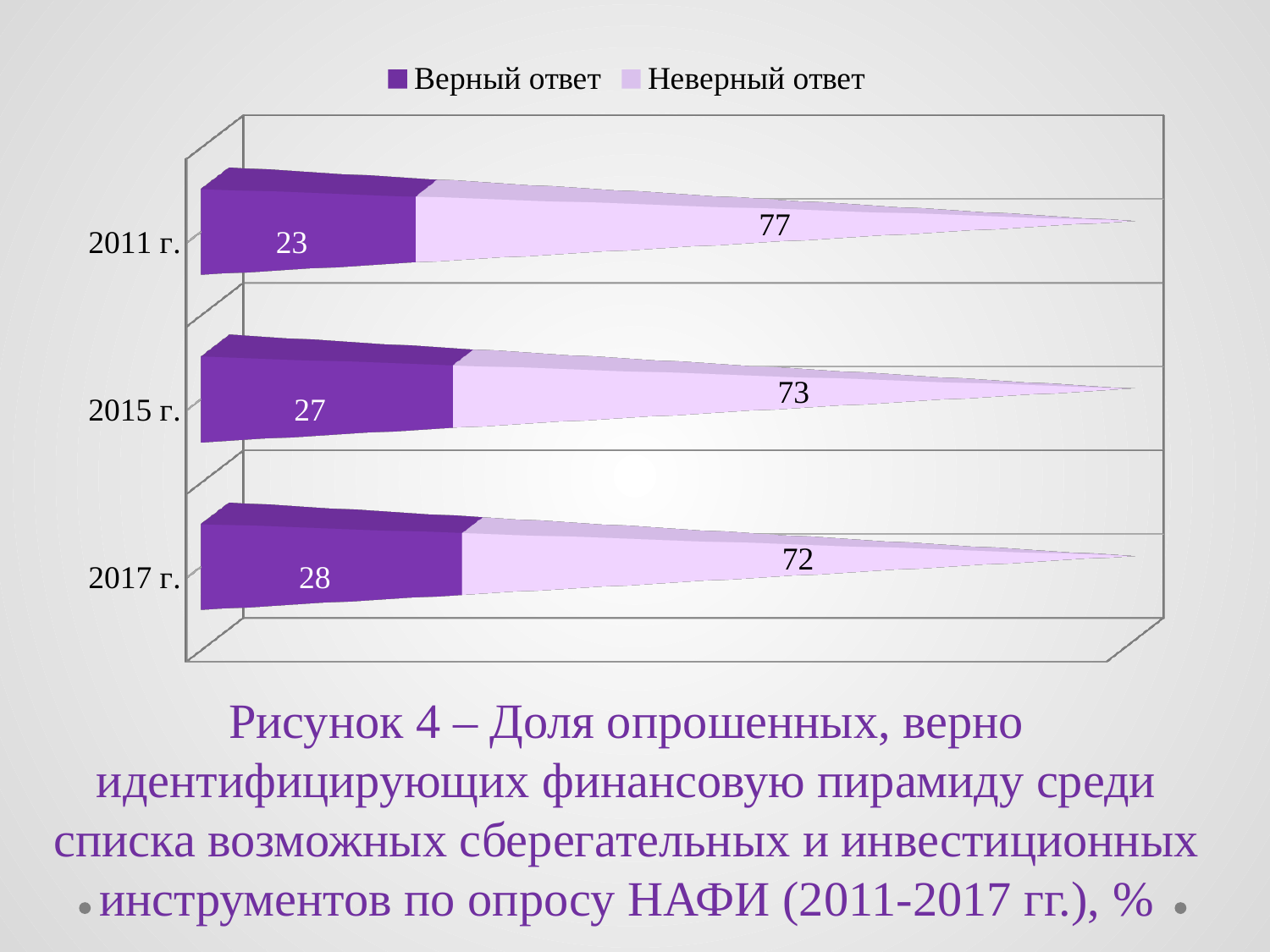
How many years (categories) are shown in the chart? 3 Which year has the lowest value for "Неверный ответ"? 2017 г. What is the difference between the "Верный ответ" values for 2017 г. and 2011 г.? 5 What is the value of "Верный ответ" for 2017 г.? 28 What is the value of "Неверный ответ" for 2015 г.? 73 Which year has the highest value for "Верный ответ"? 2017 г. Does the value of "Верный ответ" rise or fall from 2011 г. to 2017 г.? Rise How many series does the legend list? 2 What kind of chart is shown on the slide? Bar chart Which is larger: "Неверный ответ" for 2011 г. or for 2015 г.? 2011 г. What is the total of the stacked bar for 2015 г.? 100 What is the value of "Верный ответ" for 2011 г.? 23